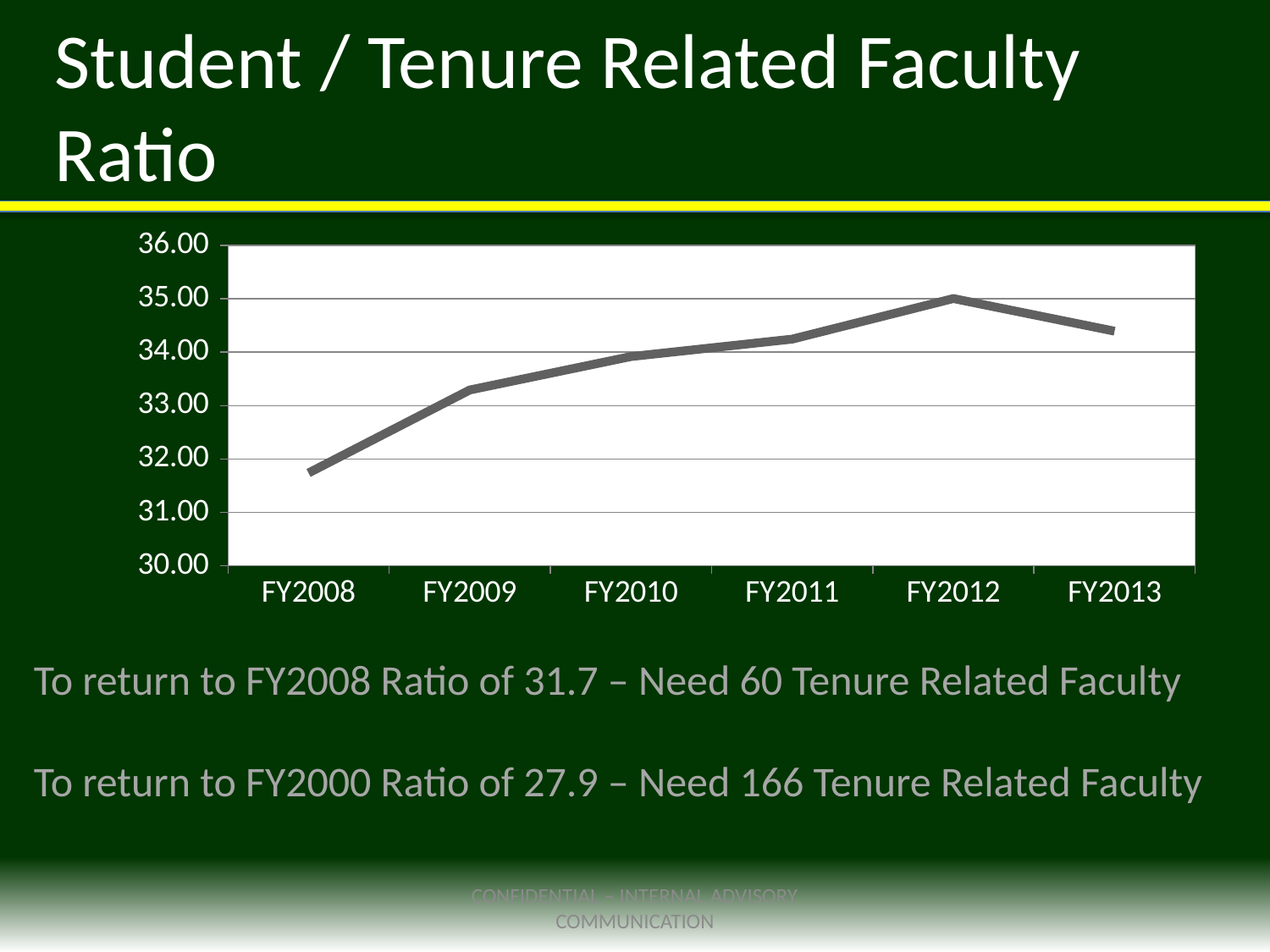
How does the ratio change from FY2008 to FY2012 in the chart? it rises Which is larger, the ratio for FY2008 or the ratio for FY2013? FY2013 Which fiscal year has the highest Student / Tenure Related Faculty Ratio in the chart? FY2012 Is the value for FY2011 greater or less than 34.00? greater Is the value for FY2009 greater or less than 33.00? greater Which is larger, the ratio for FY2009 or the ratio for FY2011? FY2011 What is the title of the slide containing the chart? Student / Tenure Related Faculty Ratio Is the value for FY2013 greater or less than 35.00? less How many fiscal years are plotted on the x axis of the chart? 6 Which fiscal year has the lowest Student / Tenure Related Faculty Ratio in the chart? FY2008 What kind of chart is shown on the slide? line chart